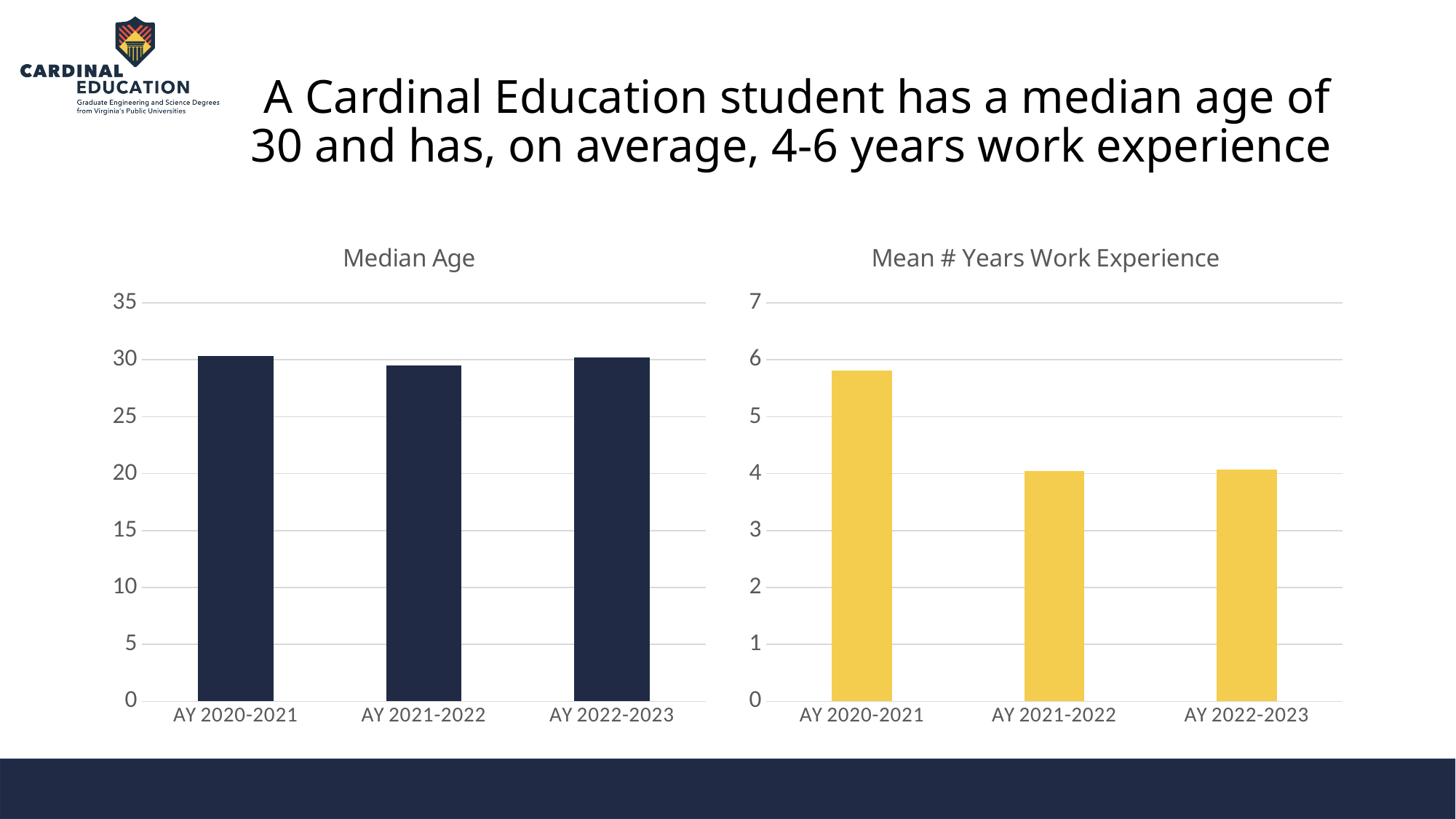
How many academic years are shown in the Median Age chart? 3 What kind of chart is the Median Age chart? bar chart In the Mean # Years Work Experience chart, is the value for AY 2020-2021 larger or smaller than the value for AY 2021-2022? larger In the Mean # Years Work Experience chart, is the value for AY 2020-2021 greater or less than 5? greater In the Median Age chart, is the value for AY 2022-2023 greater or less than 25? greater In the Median Age chart, which academic year has the lowest median age? AY 2021-2022 What kind of chart is the Mean # Years Work Experience chart? bar chart What is the title of the chart on the right side of the slide? Mean # Years Work Experience In the Mean # Years Work Experience chart, which academic year has the highest value? AY 2020-2021 In the Mean # Years Work Experience chart, is the value for AY 2022-2023 greater or less than 5? less How many bars are in the Mean # Years Work Experience chart? 3